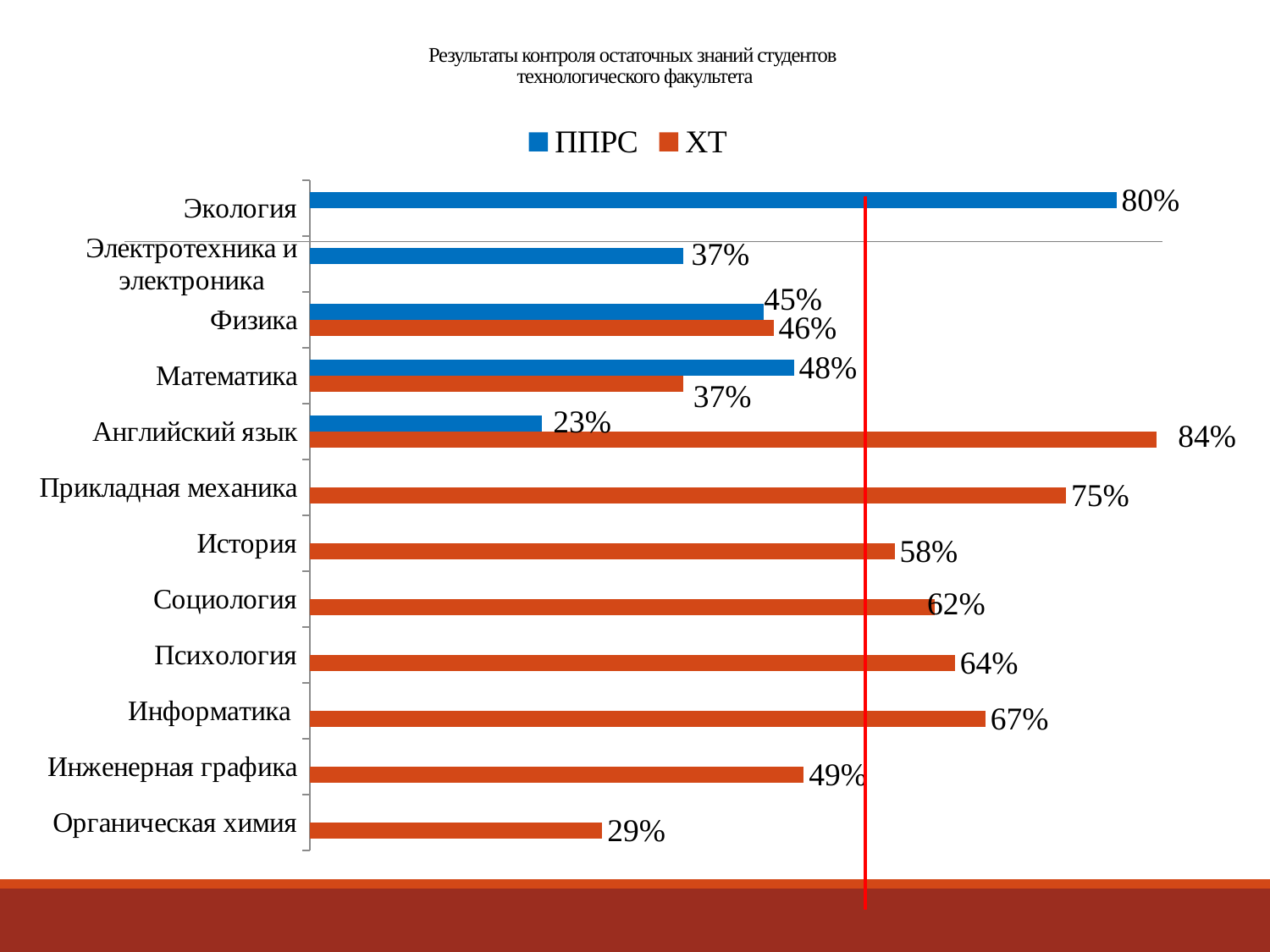
Which colour represents the ХТ series? Orange How many series does the legend list? 2 What is the difference between the ХТ and ППРС values for Английский язык? 61% Which category has the highest ХТ value? Английский язык For Математика, which is larger: the ППРС value or the ХТ value? ППРС What is the ХТ value for Органическая химия? 29% Which category has the lowest ППРС value? Английский язык What is the ППРС value for Экология? 80% What kind of chart is shown on the slide? Bar chart How many categories are shown on the chart? 12 What is the ХТ value for Английский язык? 84% What is the ППРС value for Математика? 48%